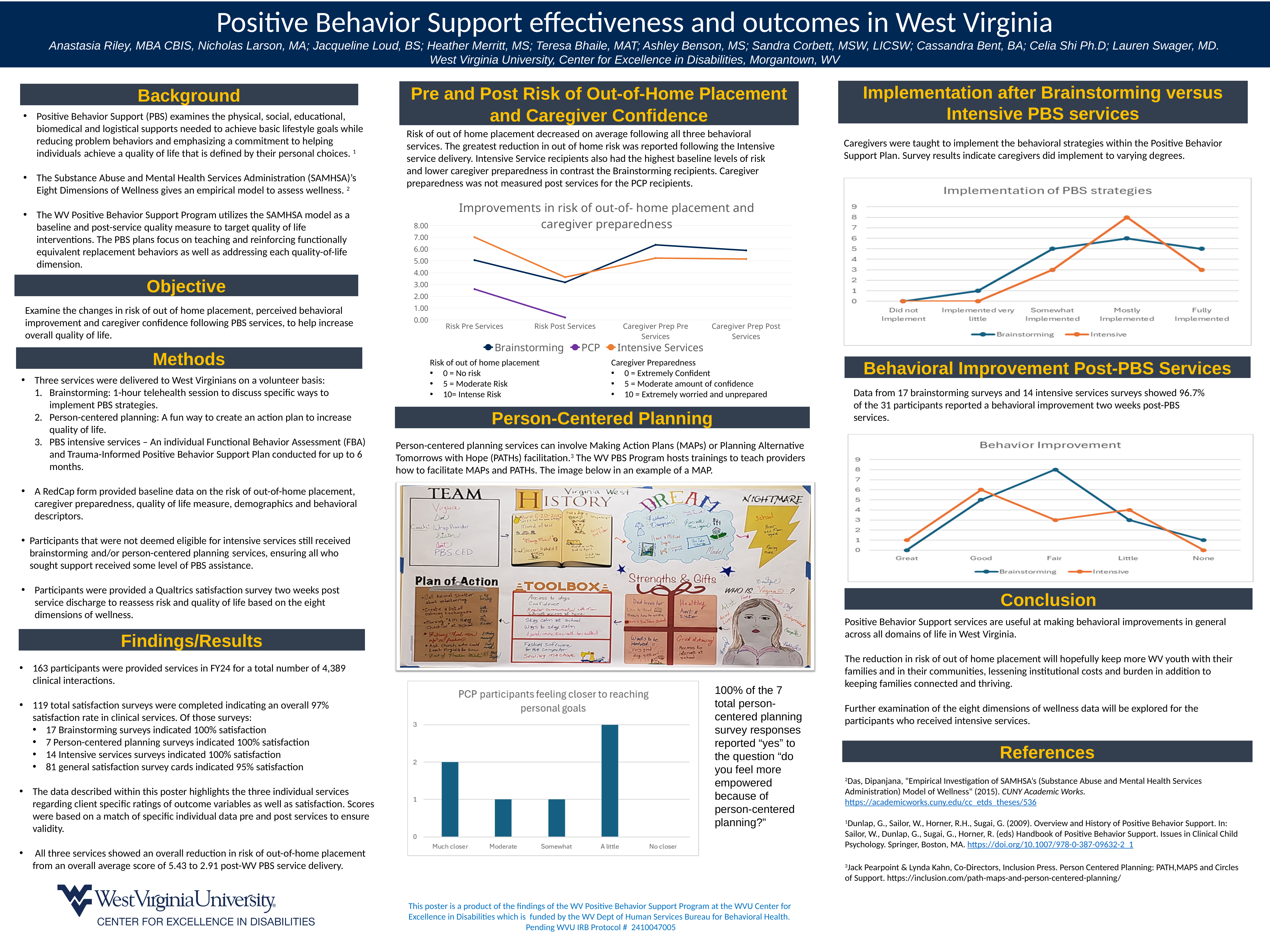
In the 'PCP participants feeling closer to reaching personal goals' chart, how many categories are on the x axis? 5 In the 'Behavior Improvement' chart, which category has the highest Brainstorming value? Fair In the 'PCP participants feeling closer to reaching personal goals' chart, which category has the highest value? A little In the 'Implementation of PBS strategies' chart, what is the Intensive value for 'Mostly Implemented'? 8 In the 'PCP participants feeling closer to reaching personal goals' chart, what is the value for 'A little'? 3 In the 'Implementation of PBS strategies' chart, how many series does the legend list? 2 In the 'Implementation of PBS strategies' chart, which series is higher at 'Somewhat Implemented', Brainstorming or Intensive? Brainstorming In the 'PCP participants feeling closer to reaching personal goals' chart, what kind of chart is shown? bar chart In the 'Improvements in risk of out-of- home placement and caregiver preparedness' chart, how many series does the legend list? 3 In the 'Improvements in risk of out-of- home placement and caregiver preparedness' chart, is the Intensive Services value for 'Risk Pre Services' greater or less than 6.00? greater In the 'Behavior Improvement' chart, what is the Intensive value for 'None'? 0 In the 'PCP participants feeling closer to reaching personal goals' chart, what is the difference between 'A little' and 'Much closer'? 1